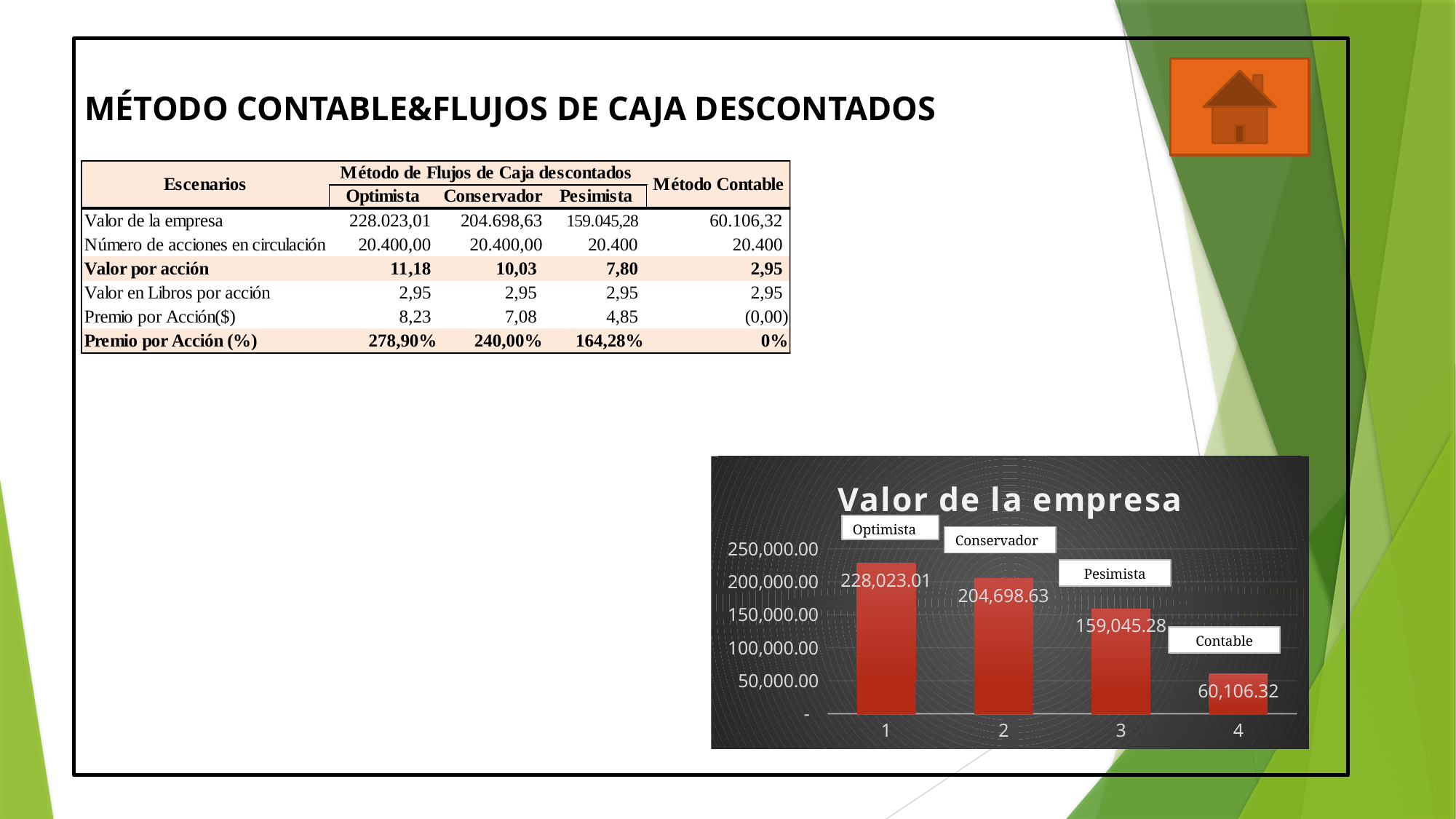
What type of chart is shown on the slide? bar chart Which bar has the lowest value? Contable (bar 4) How many bars are plotted in the chart? 4 What is the value of the bar labelled Pesimista (bar 3)? 159,045.28 Which bar has the highest value? Optimista (bar 1) What is the value of the bar labelled Contable (bar 4)? 60,106.32 Do the bar values rise or fall from bar 1 to bar 4? fall What is the difference between the Optimista bar and the Conservador bar? 23,324.38 What is the difference between the Pesimista bar and the Contable bar? 98,938.96 What is the title of the chart? Valor de la empresa What is the value of the bar labelled Conservador (bar 2)? 204,698.63 What is the value of the bar labelled Optimista (bar 1)? 228,023.01